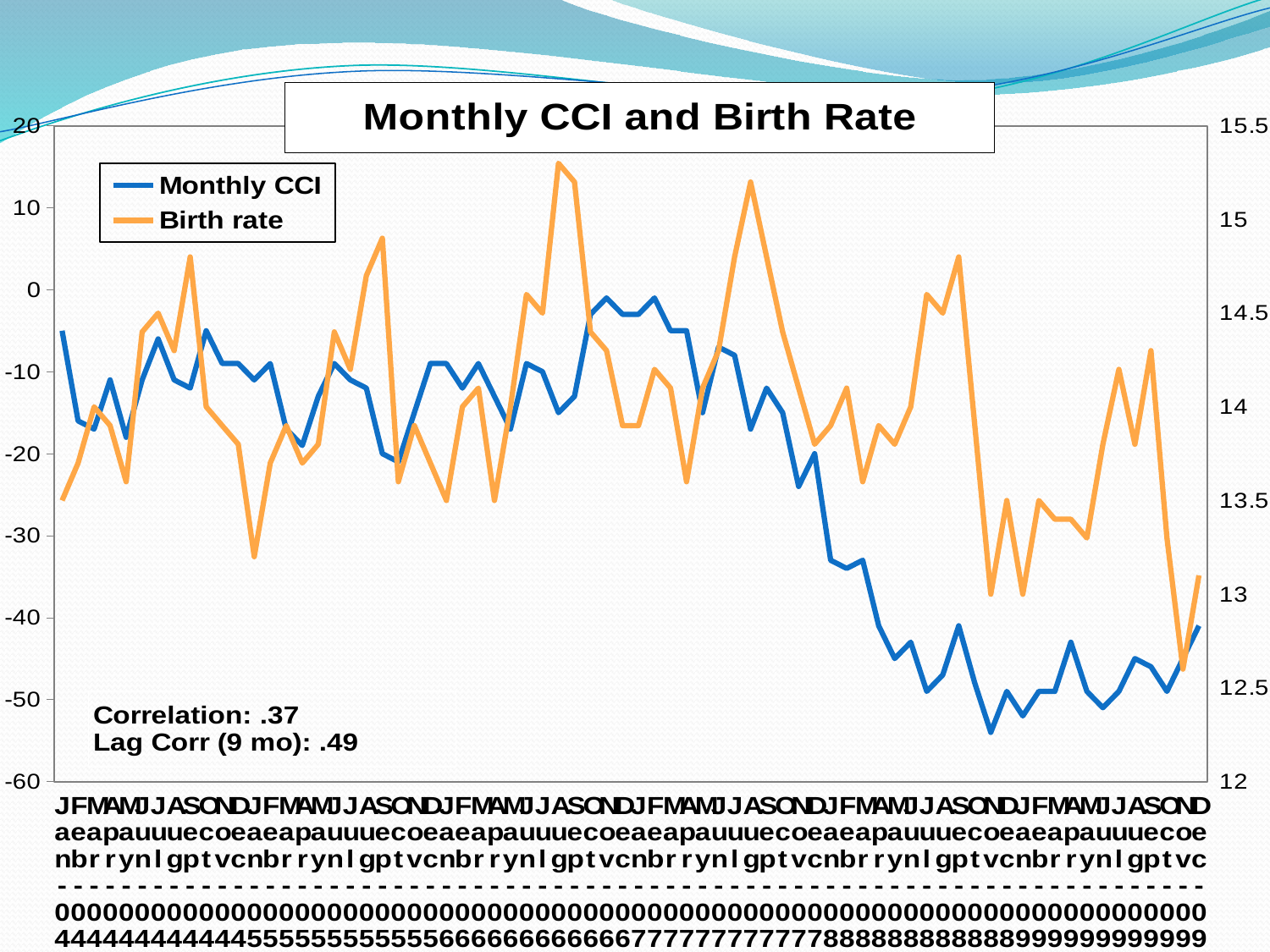
In which year does the Monthly CCI series reach its lowest point? 2008 How many series does the legend list? 2 Is the Monthly CCI value for January 2004 greater or less than -10? greater Which series is drawn in orange? Birth rate Is the lowest Monthly CCI value in 2009 greater or less than -50? less What is the title of the chart? Monthly CCI and Birth Rate Does the Monthly CCI series generally rise or fall from 2007 to 2009? fall Is the lowest Birth rate value in 2009 greater or less than 13? less What kind of chart is shown on the slide? Line chart How many years of monthly data does the x axis cover? 6